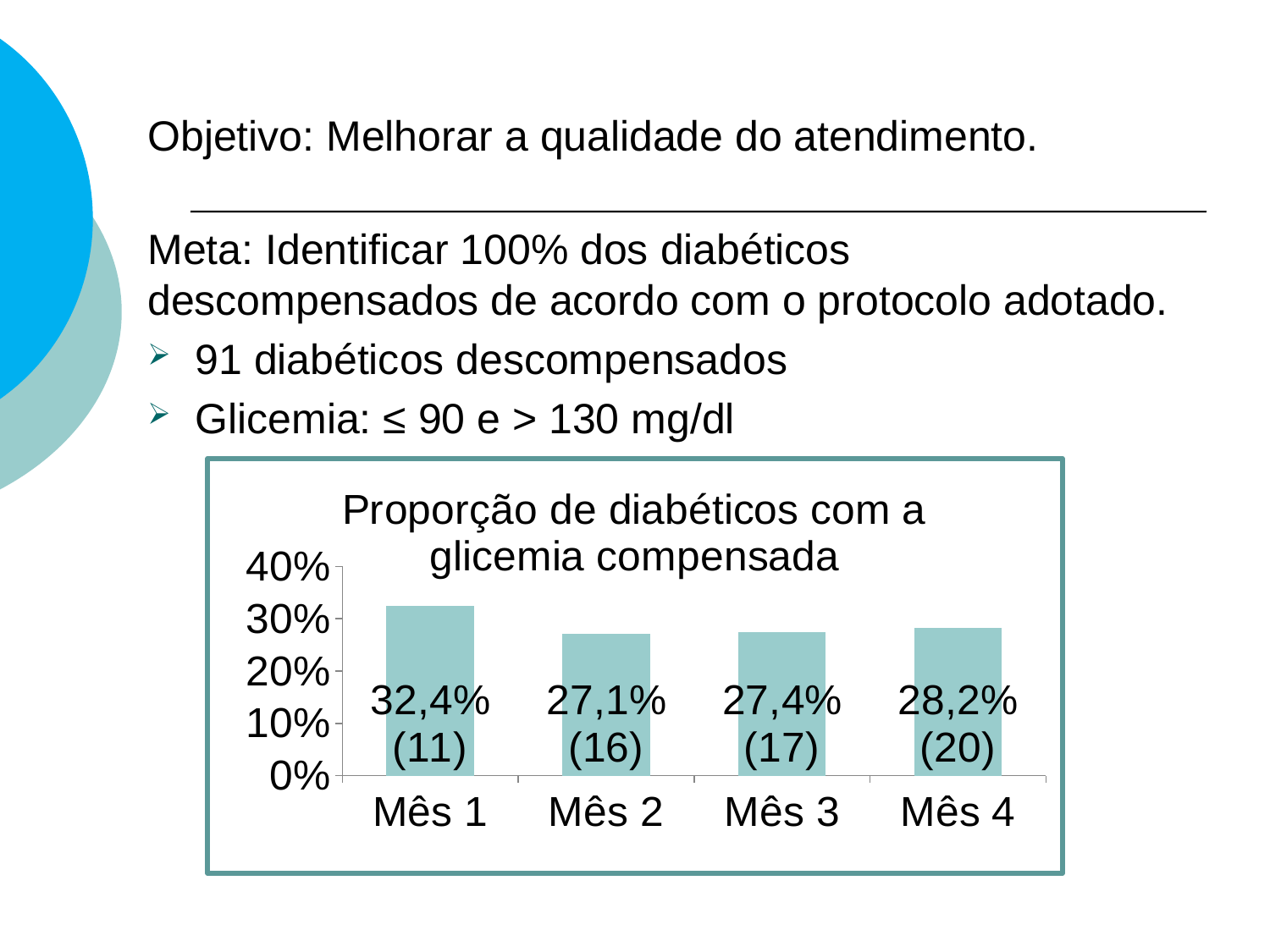
How many months are shown on the x axis? 4 Which month has the lowest proportion? Mês 2 What count is shown in parentheses for Mês 3? 17 Is the value for Mês 1 greater or less than 30%? greater What is the title of the chart? Proporção de diabéticos com a glicemia compensada Which is larger, the value for Mês 3 or the value for Mês 4? Mês 4 What is the difference between the values for Mês 1 and Mês 2? 5,3% What kind of chart is shown? bar chart What is the value for Mês 2? 27,1% Which month has the highest proportion? Mês 1 What is the value for Mês 1? 32,4% What is the value for Mês 4? 28,2%